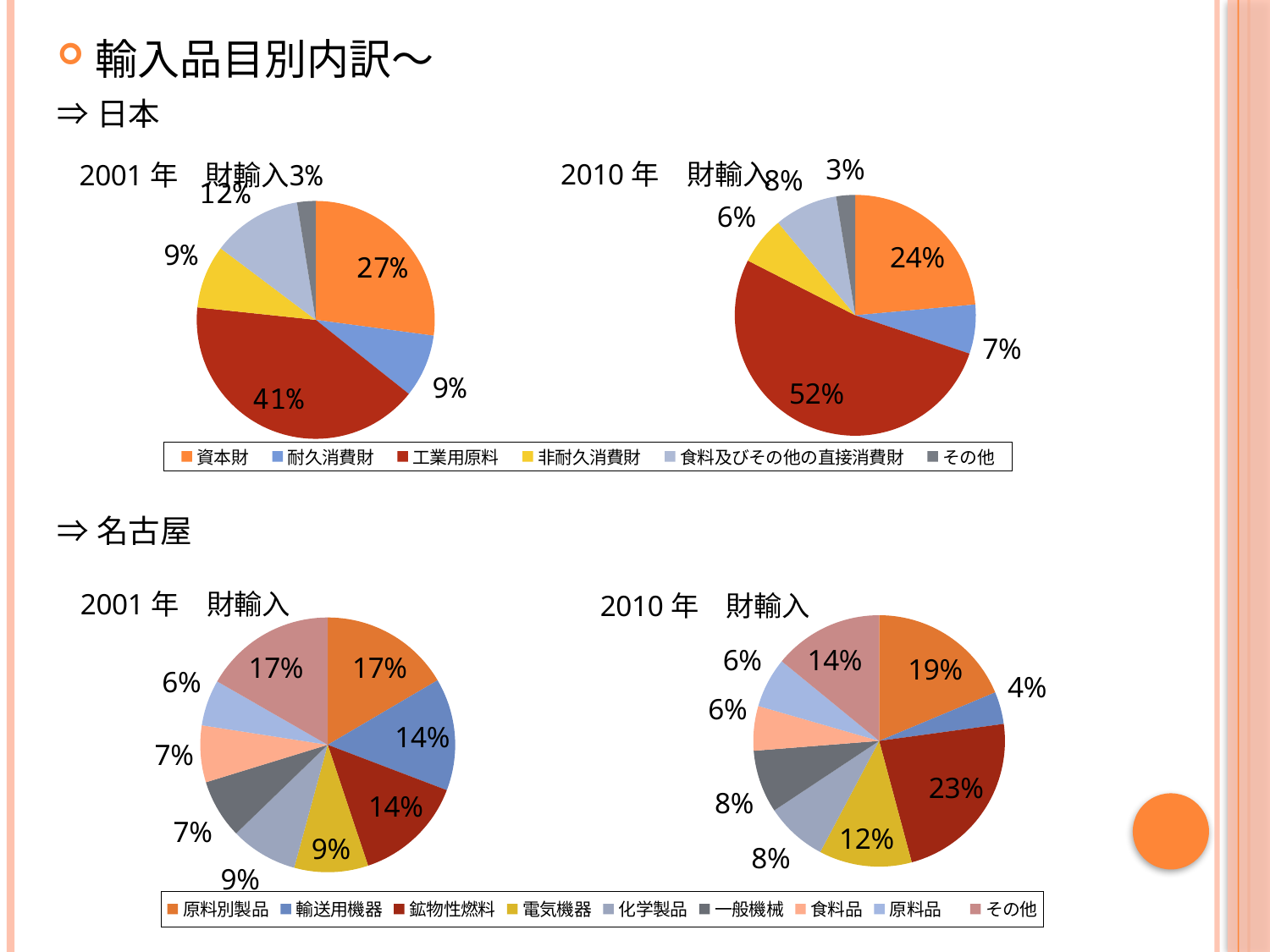
In the 名古屋 2001年 財輸入 pie chart, what share does 電気機器 have? 9% In the 日本 2010年 財輸入 pie chart, what share does 工業用原料 have? 52% In the 日本 2001年 財輸入 pie chart, what share does 工業用原料 have? 41% What type of chart is used on this slide? Pie chart In the 名古屋 2010年 財輸入 pie chart, which category has the smallest share? 輸送用機器 How many categories does the legend of the 日本 pie charts list? 6 In the 日本 2010年 財輸入 pie chart, which category has the smallest share? その他 In the 日本 2010年 財輸入 pie chart, what share does 資本財 have? 24% In the 日本 2001年 財輸入 pie chart, which category has the largest share? 工業用原料 In the 名古屋 2010年 財輸入 pie chart, which is larger: 原料別製品 or その他? 原料別製品 In the 名古屋 2010年 財輸入 pie chart, what share does 鉱物性燃料 have? 23% What is the difference between the 工業用原料 share in the 日本 2010年 chart and the 日本 2001年 chart? 11 percentage points